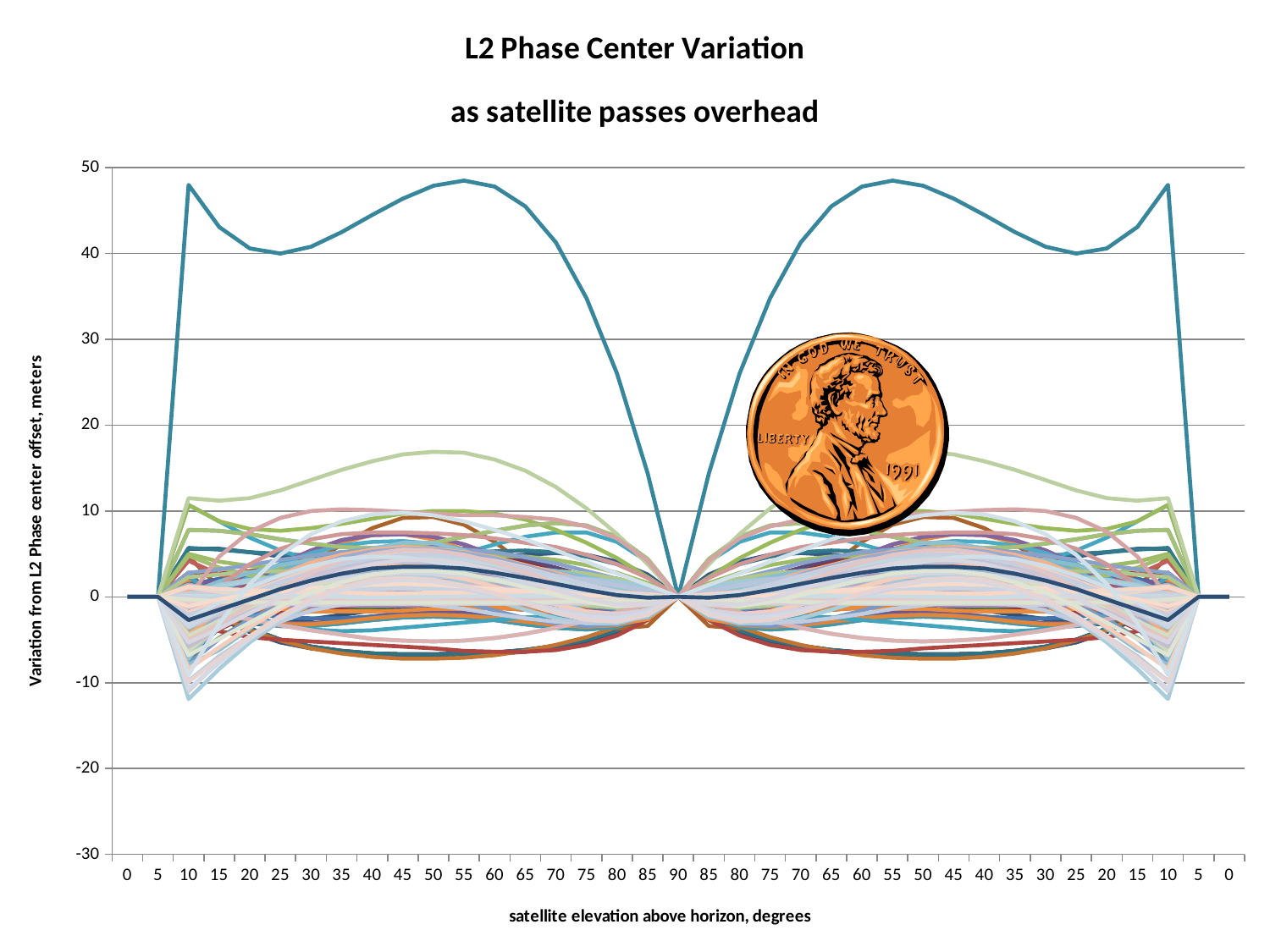
Is the value of the highest line at 55 degrees elevation greater or less than 40? greater Is the value of the highest line at 75 degrees elevation greater or less than 40? less What kind of chart is shown on the slide? line chart What is the label of the vertical axis? Variation from L2 Phase center offset, meters Is the value of the highest line at 10 degrees elevation greater or less than 40? greater Does the highest line rise or fall between 25 and 55 degrees elevation on the left side of the chart? rise What is the highest value shown on the vertical axis? 50 What is the lowest value shown on the vertical axis? -30 What is the maximum elevation shown on the horizontal axis? 90 What value do all the lines converge to at 90 degrees elevation? 0